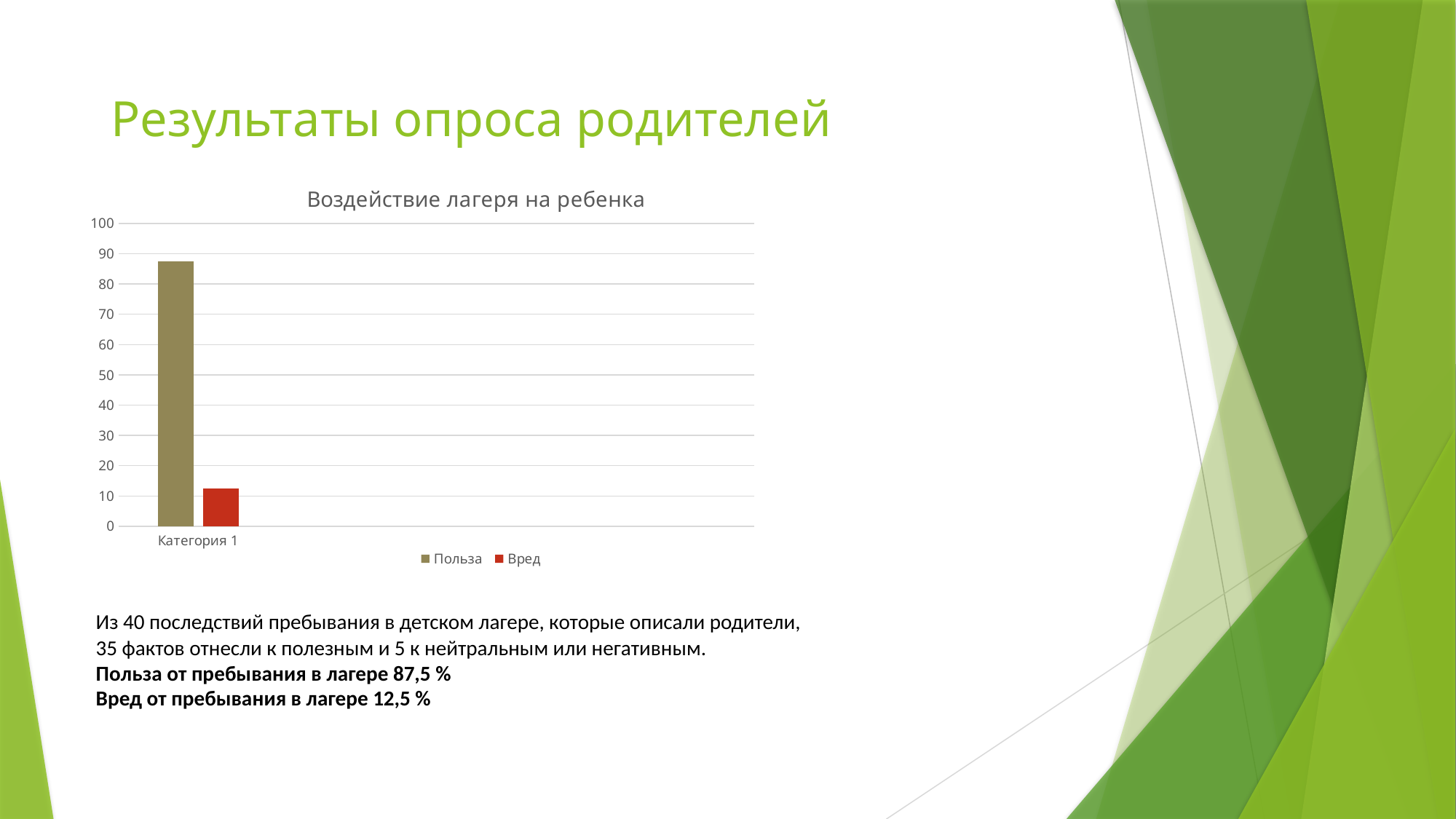
Is the bar for Вред greater or less than 20? less What kind of chart is shown on the slide? bar chart Is the bar for Польза greater or less than 80? greater How many categories are shown on the x axis of the chart? 1 Which is larger, the value for Польза or the value for Вред? Польза Is the bar for Польза greater or less than 90? less What are the two series named in the legend? Польза and Вред Which series has the higher bar for Категория 1? Польза Which series has the lower bar for Категория 1? Вред What is the title of the chart? Воздействие лагеря на ребенка How many series does the chart legend list? 2